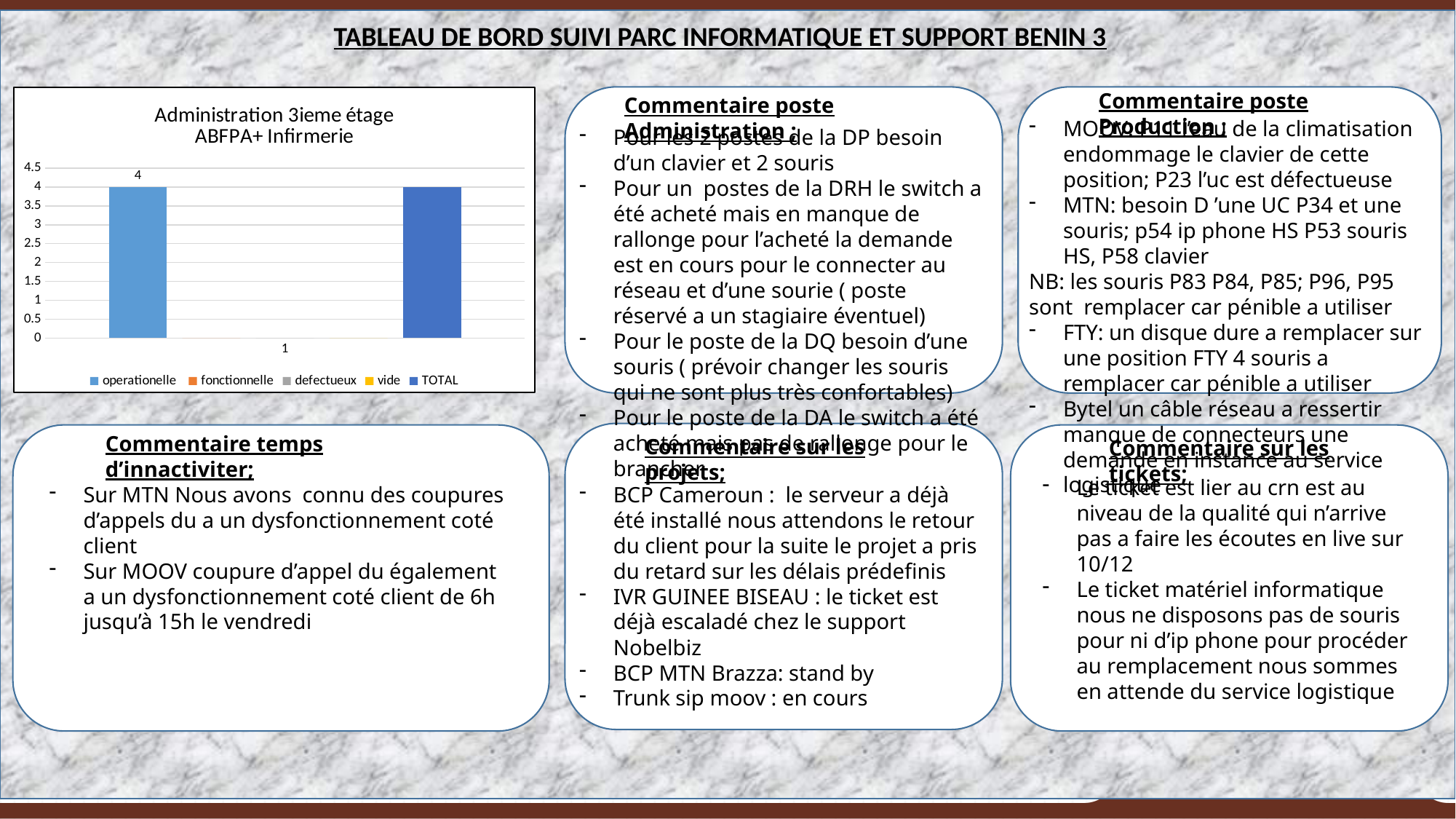
What kind of chart is shown on the slide? bar chart What is the value of the operationelle bar? 4 How many categories are shown on the x axis of the chart? 1 What is the label of the single category on the x axis? 1 Which is larger, the TOTAL bar or the defectueux bar? TOTAL What is the title of the chart? Administration 3ieme étage ABFPA+ Infirmerie Which is larger, the operationelle bar or the fonctionnelle bar? operationelle How many series does the chart legend list? 5 What is the highest tick value shown on the y axis of the chart? 4.5 Is the value of the operationelle bar greater or less than 2? greater Is the value of the TOTAL bar greater or less than 3? greater